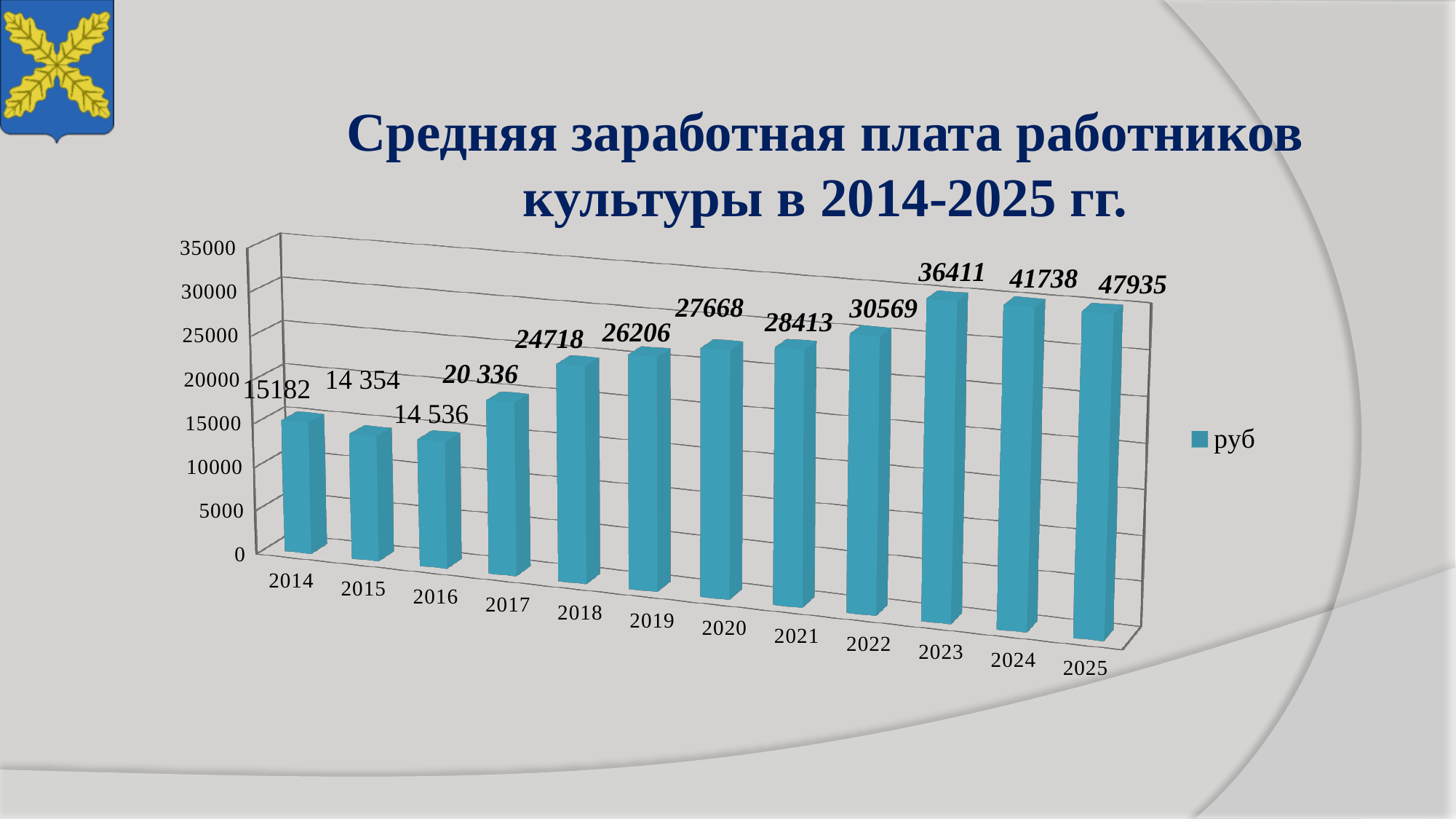
Which year has the lowest value? 2015 What is the difference between the values for 2019 and 2018? 1488 What is the difference between the values for 2025 and 2024? 6197 What is the value for 2022? 30569 What kind of chart is shown on the slide? Bar chart What is the value for 2014? 15182 Which year has the highest value? 2025 How many years are shown on the x axis? 12 What is the only entry listed in the legend? руб What is the value for 2017? 20 336 What is the value for 2025? 47935 Which is larger, the value for 2016 or the value for 2015? 2016